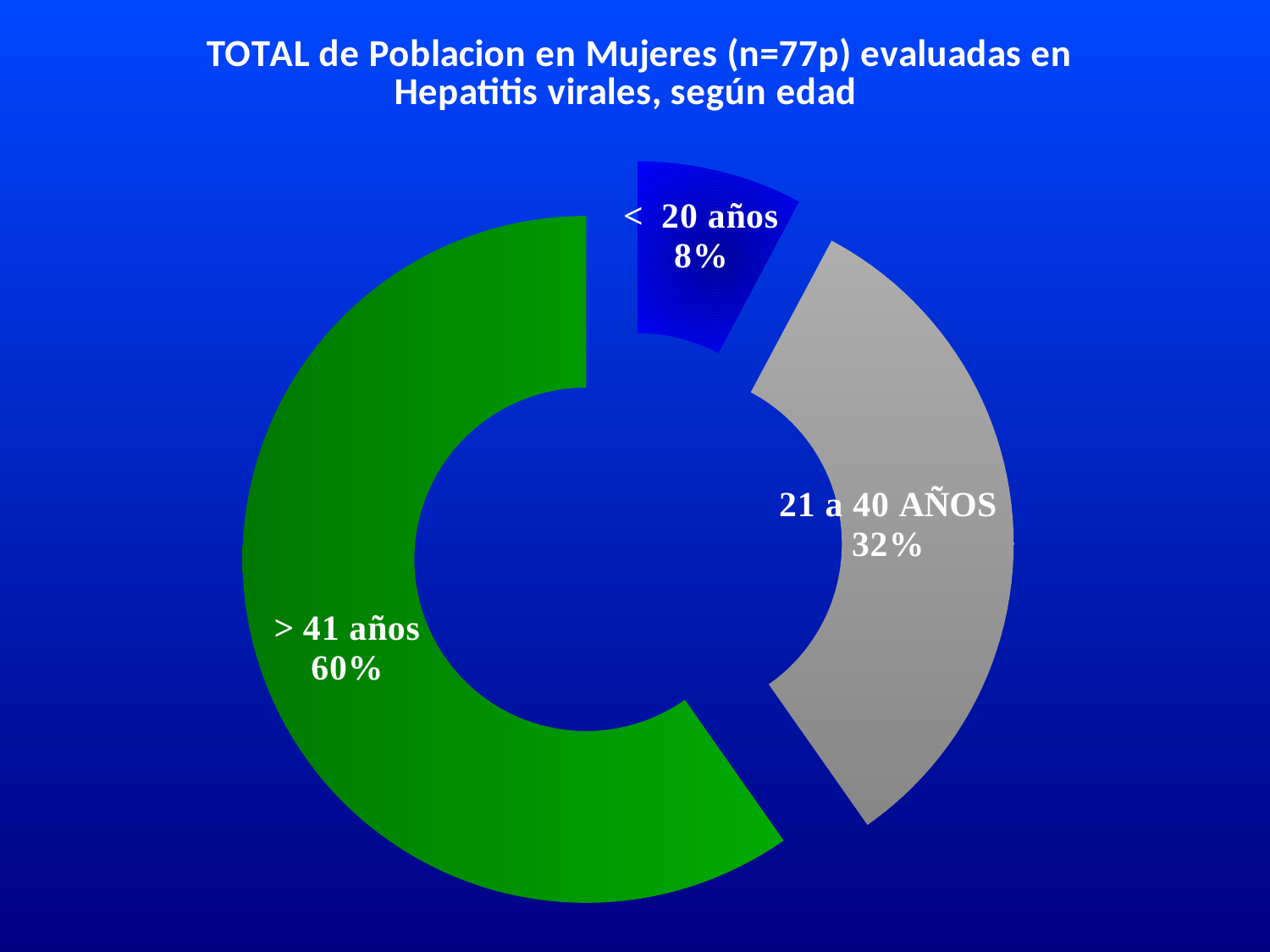
How many age groups are shown in the chart? 3 What is the difference in percentage points between the '21 a 40 AÑOS' and '< 20 años' groups? 24 What colour is the '> 41 años' segment? Green What percentage of the women evaluated are in the '21 a 40 AÑOS' group? 32% Which age group has the largest share of the chart? > 41 años Which age group has the smallest share of the chart? < 20 años What type of chart is shown on the slide? Doughnut (pie) chart Which group has a larger share: '21 a 40 AÑOS' or '< 20 años'? 21 a 40 AÑOS What percentage of the women evaluated are in the '> 41 años' group? 60% What is the difference in percentage points between the '> 41 años' and '21 a 40 AÑOS' groups? 28 What percentage of the women evaluated are in the '< 20 años' group? 8% What is the title of the chart? TOTAL de Poblacion en Mujeres (n=77p) evaluadas en Hepatitis virales, según edad